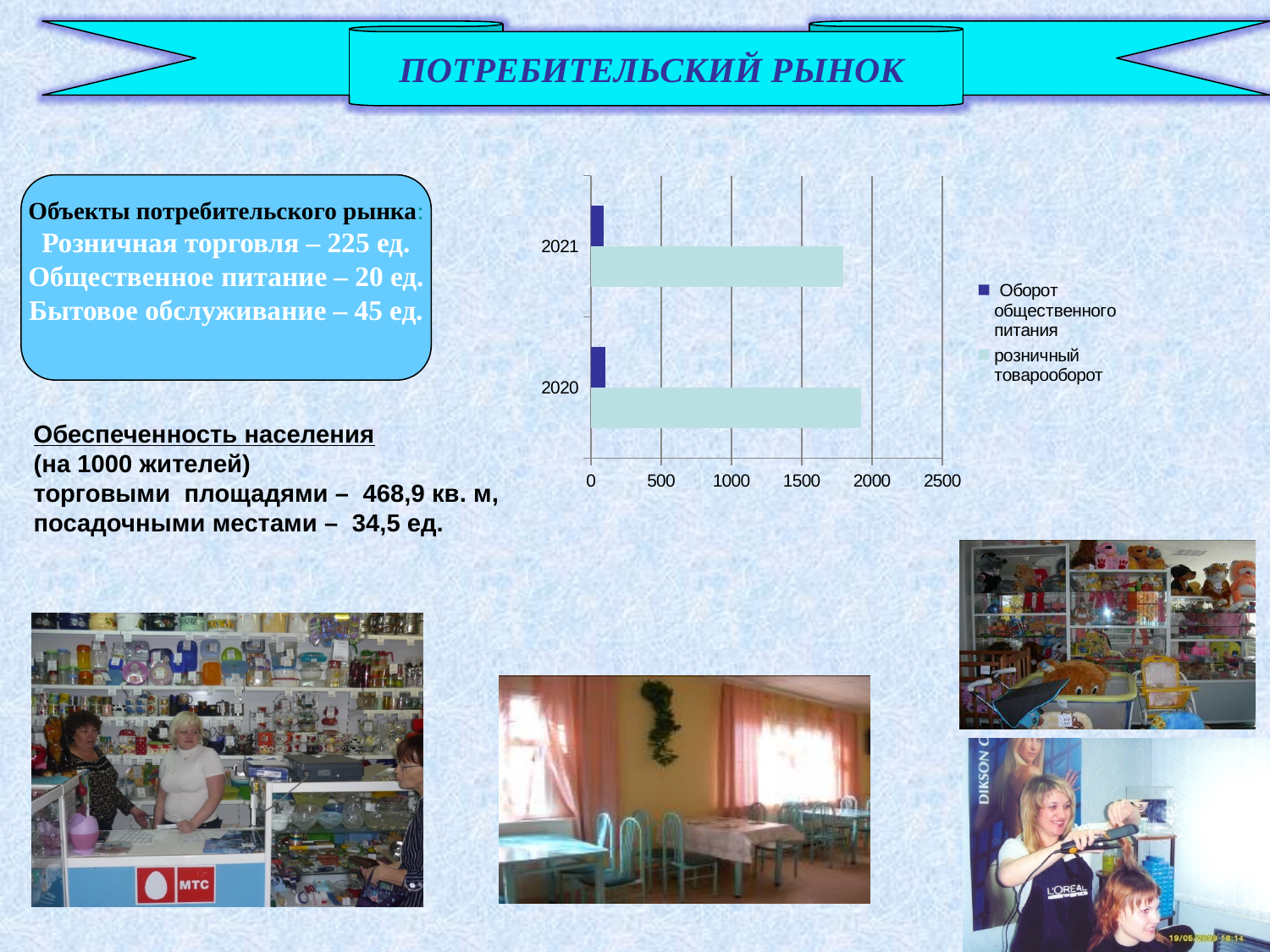
What kind of chart is shown on the slide? bar chart How many series does the chart legend list? 2 Is the value of розничный товарооборот for 2021 greater or less than 1500? greater Is the value of Оборот общественного питания for 2021 greater or less than 500? less Does розничный товарооборот rise or fall from 2020 to 2021? fall Which series does the light colour represent in the chart? розничный товарооборот Is the value of розничный товарооборот for 2020 greater or less than 2000? less How many years (categories) are shown on the chart? 2 Which series does the dark blue colour represent in the chart? Оборот общественного питания Which year has the higher value of розничный товарооборот? 2020 In 2021, which is larger: розничный товарооборот or Оборот общественного питания? розничный товарооборот